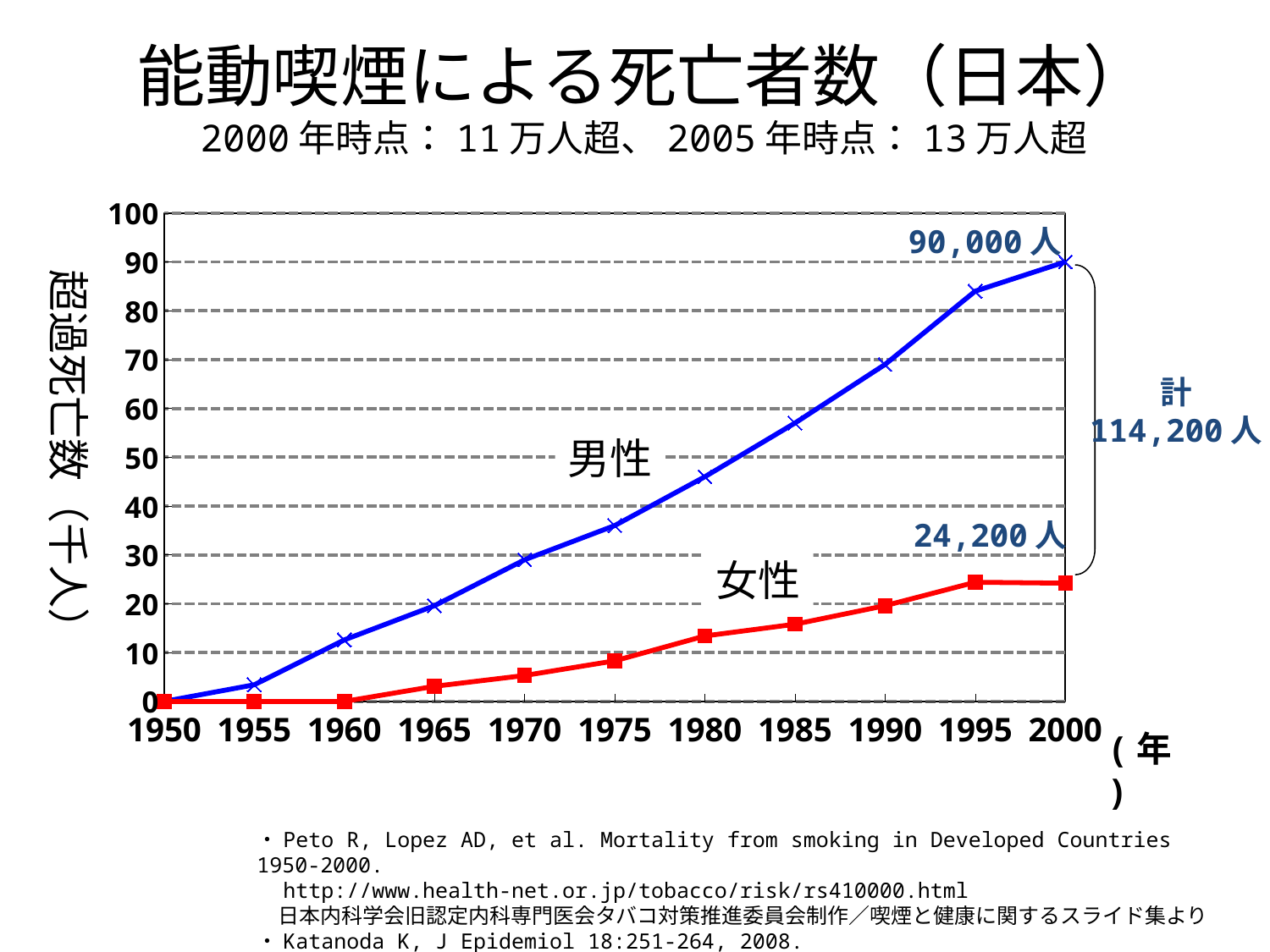
Is the value for 男性 in 1990 greater or less than 60? greater Is the value for 女性 in 1985 greater or less than 20? less In 2000, which series has the larger value, 男性 or 女性? 男性 How many series are plotted on the chart? 2 What is the labelled value for 男性 (men) in 2000? 90,000人 What is the combined total of men and women shown for 2000? 114,200人 What is the label on the vertical axis? 超過死亡数（千人） What is the labelled value for 女性 (women) in 2000? 24,200人 What is the difference between the 2000 values for 男性 and 女性? 65,800人 Does the 男性 line rise or fall from 1950 to 2000? rise How many data points (years) are plotted for each series? 11 What kind of chart is shown on the slide? line chart